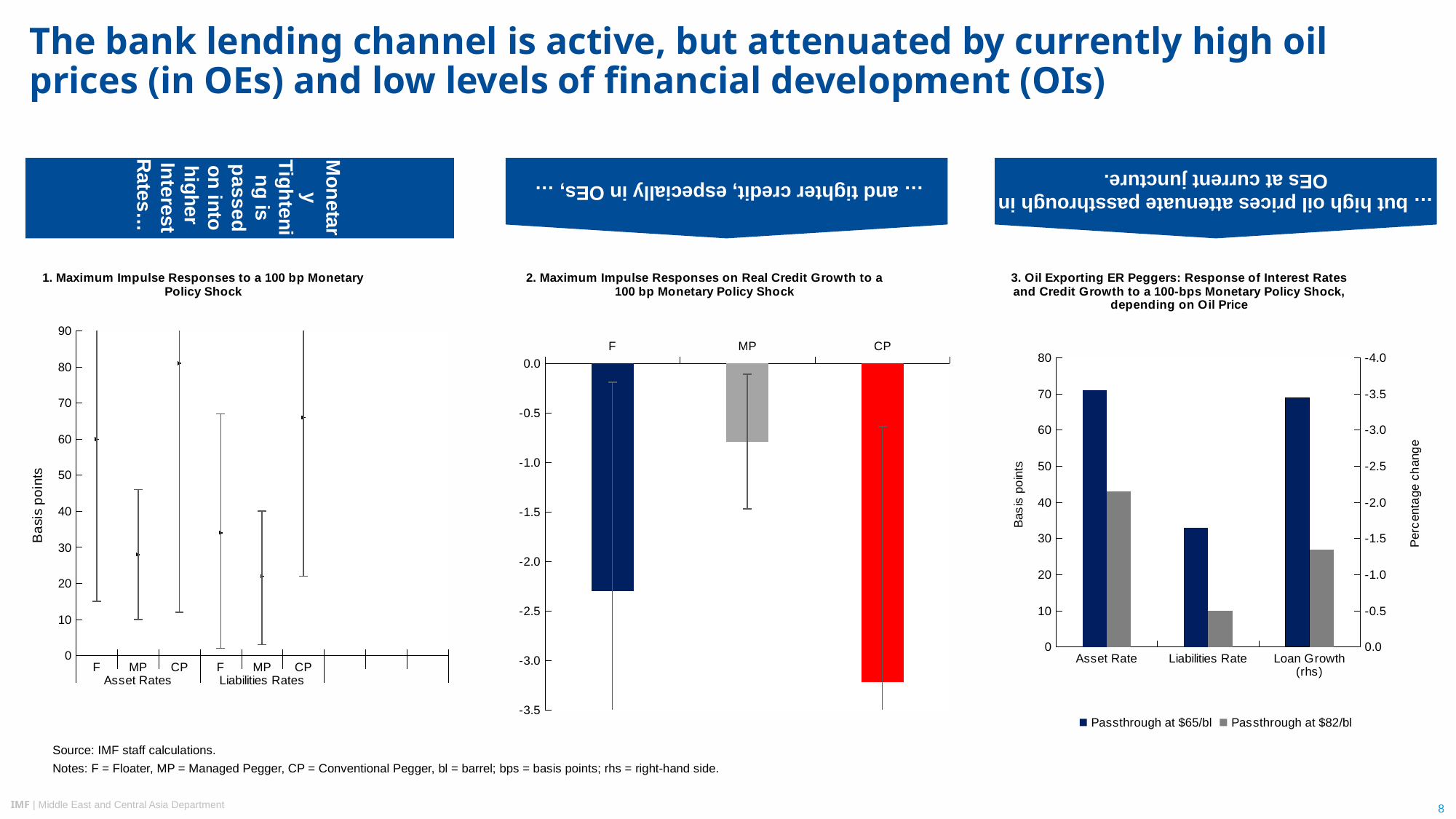
In the chart titled "2. Maximum Impulse Responses on Real Credit Growth to a 100 bp Monetary Policy Shock", is the value for CP greater or less than -3.0? less In the chart titled "3. Oil Exporting ER Peggers: Response of Interest Rates and Credit Growth to a 100-bps Monetary Policy Shock, depending on Oil Price", how many series does the legend list? 2 In the chart titled "3. Oil Exporting ER Peggers", what are the two legend entries? Passthrough at $65/bl and Passthrough at $82/bl In the chart titled "1. Maximum Impulse Responses to a 100 bp Monetary Policy Shock", what is the label on the vertical axis? Basis points In the chart titled "2. Maximum Impulse Responses on Real Credit Growth to a 100 bp Monetary Policy Shock", how many categories are plotted? 3 In the chart titled "3. Oil Exporting ER Peggers", is the Passthrough at $65/bl value for Asset Rate greater or less than 60? greater In the chart titled "2. Maximum Impulse Responses on Real Credit Growth to a 100 bp Monetary Policy Shock", is the value for MP greater or less than -1.0? greater In the chart titled "2. Maximum Impulse Responses on Real Credit Growth to a 100 bp Monetary Policy Shock", which category has the lowest (most negative) value? CP In the chart titled "3. Oil Exporting ER Peggers", what kind of chart is shown? bar chart In the chart titled "3. Oil Exporting ER Peggers", which is larger for Asset Rate: Passthrough at $65/bl or Passthrough at $82/bl? Passthrough at $65/bl In the chart titled "3. Oil Exporting ER Peggers", which category has the lowest Passthrough at $82/bl bar? Liabilities Rate